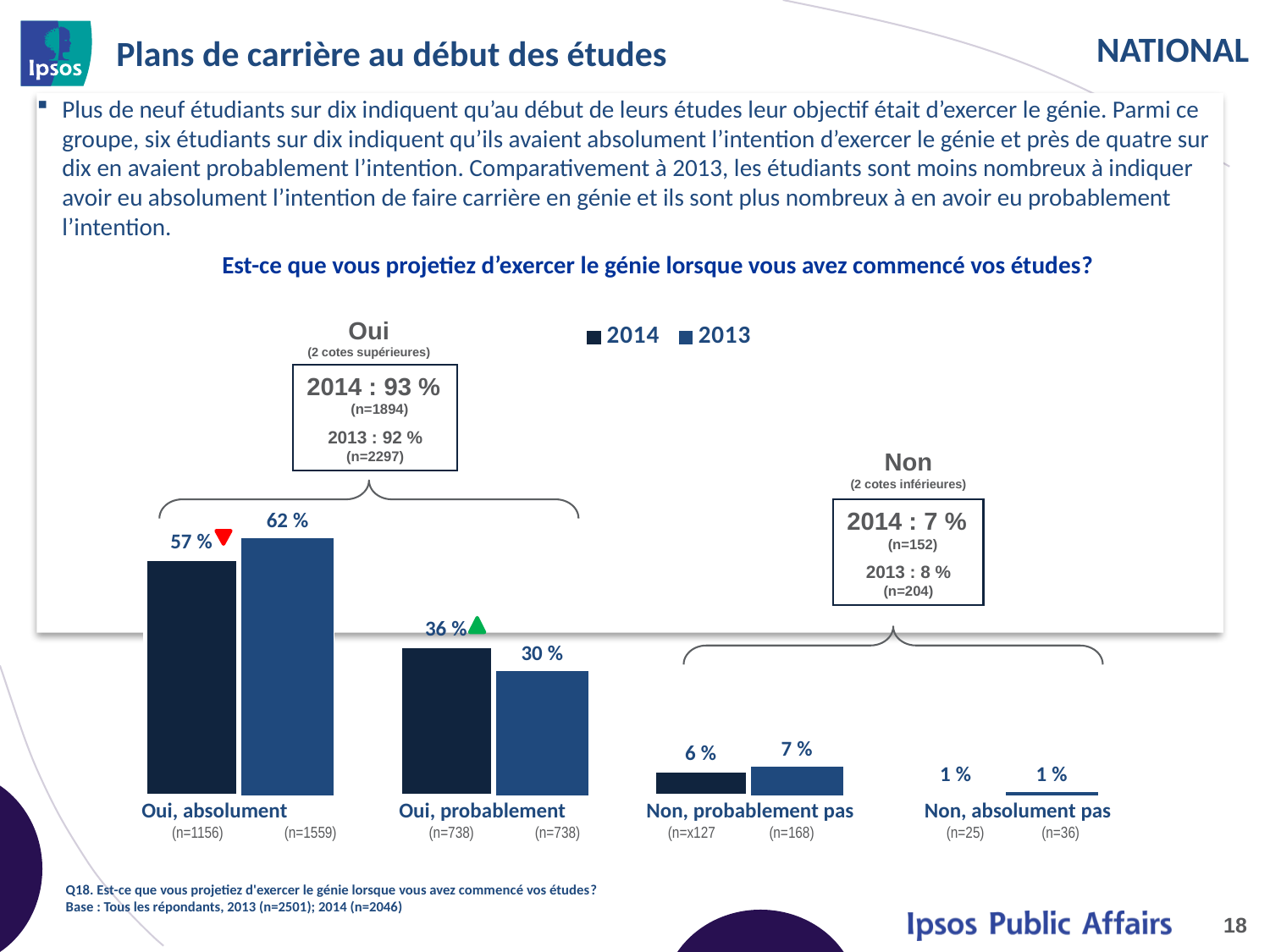
What kind of chart is shown on the slide? Bar chart What is the 2014 value for "Oui, absolument"? 57 % Which series is shown in the darker navy colour in the legend? 2014 How many series does the legend list? 2 What is the difference between the 2014 and 2013 values for "Oui, probablement"? 6 % How many categories are shown on the x axis of the chart? 4 What is the difference between the 2013 and 2014 values for "Oui, absolument"? 5 % Which category has the lowest 2013 value? Non, absolument pas What is the 2013 value for "Non, probablement pas"? 7 % Which category has the highest 2014 value? Oui, absolument What is the 2013 value for "Oui, probablement"? 30 % For "Oui, probablement", which year has the larger value, 2014 or 2013? 2014